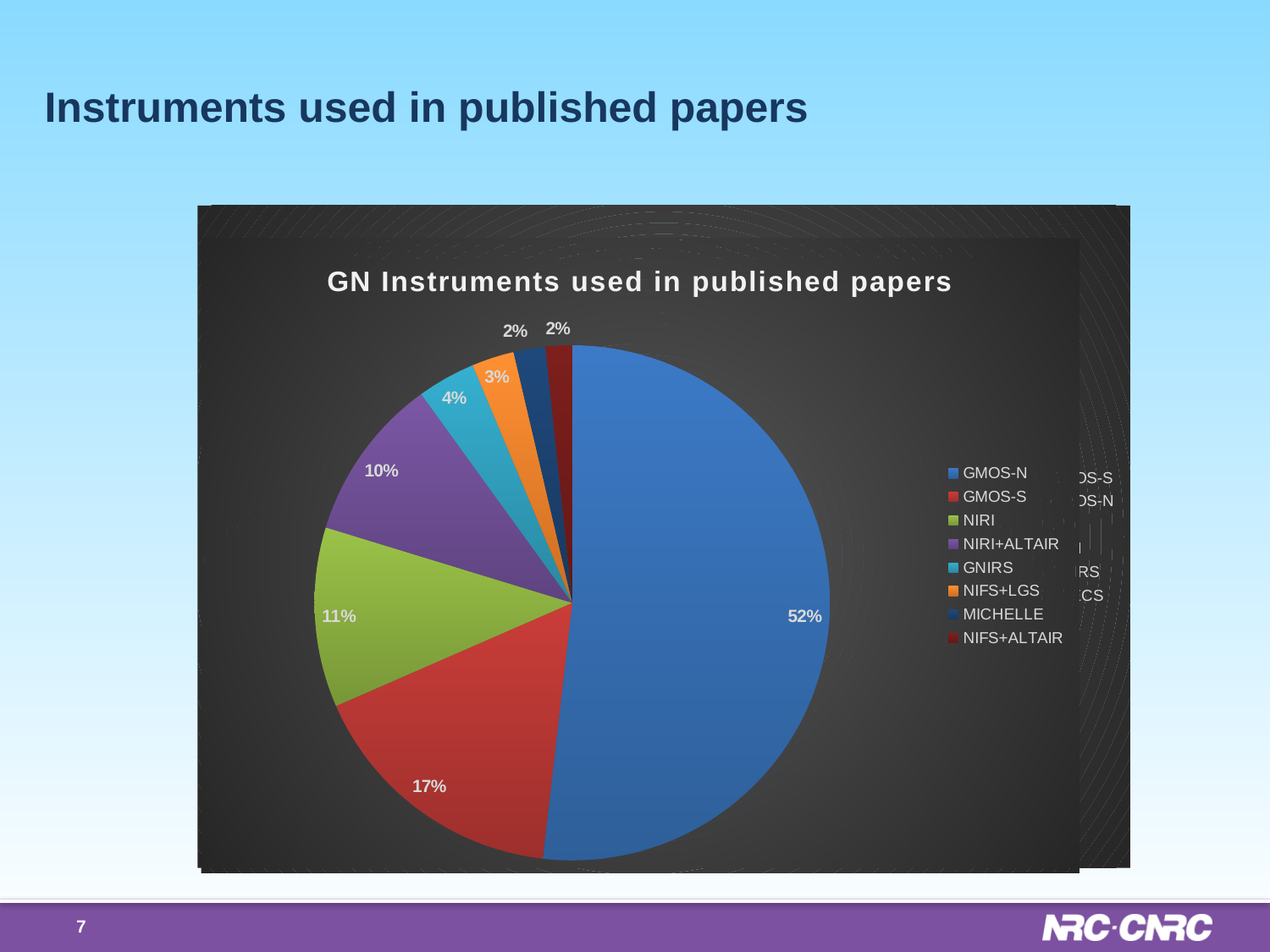
What share of the pie does GMOS-N have? 52% What share of the pie does GNIRS have? 4% What share of the pie does NIRI have? 11% Which has a larger share, NIRI or NIRI+ALTAIR? NIRI What is the difference between the shares of GMOS-N and GMOS-S? 35% How many instruments does the legend list? 8 What is the title of the chart? GN Instruments used in published papers Which instrument has the largest share of the pie? GMOS-N What kind of chart is shown on the slide? pie chart